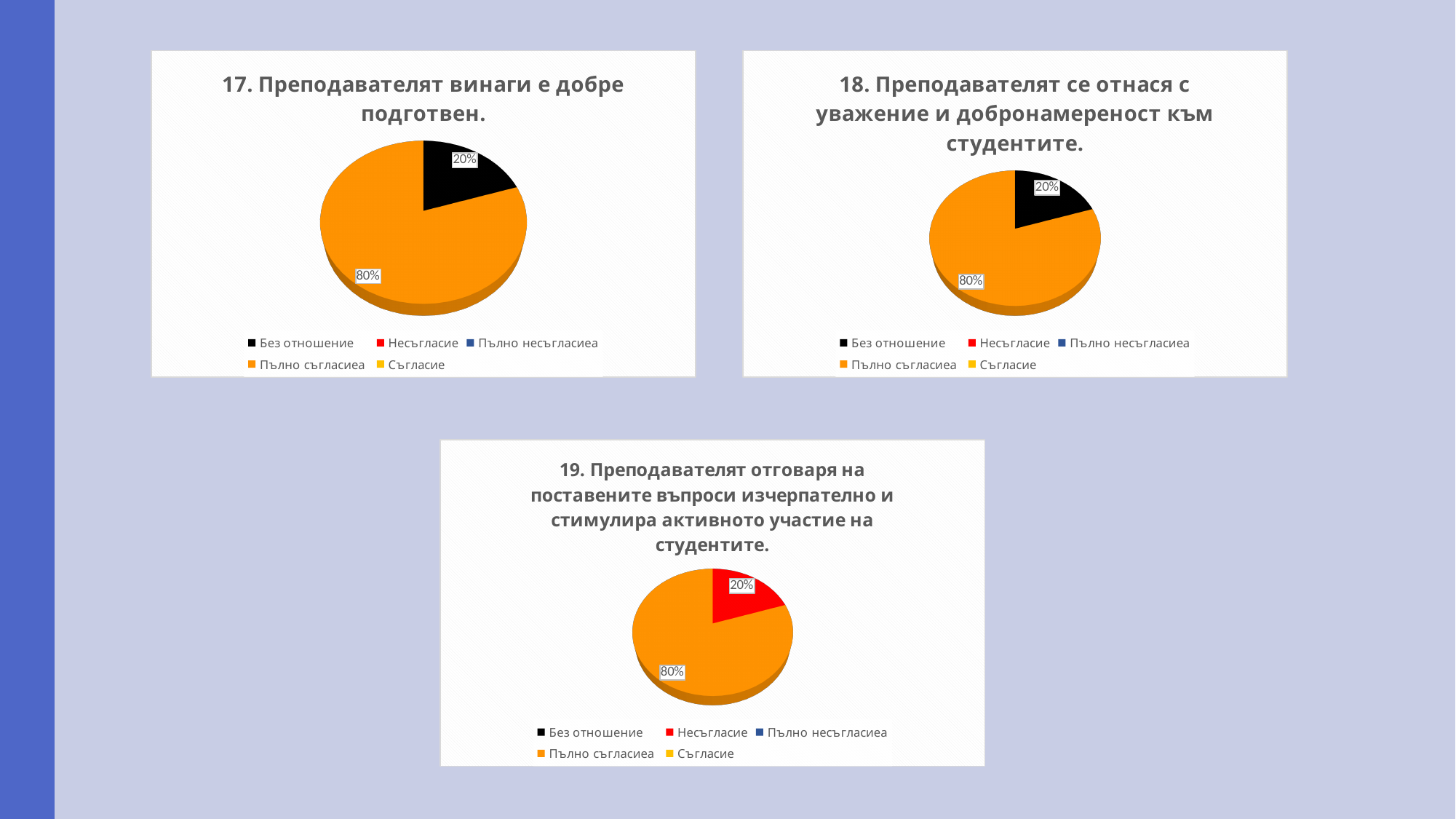
In the chart titled "17. Преподавателят винаги е добре подготвен.", what share of the pie is "Без отношение"? 20% What kind of chart is the chart titled "17. Преподавателят винаги е добре подготвен."? Pie chart In the chart titled "18. Преподавателят се отнася с уважение и добронамереност към студентите.", what is the difference between the "Пълно съгласиеа" slice and the "Без отношение" slice? 60% In the chart titled "19. Преподавателят отговаря на поставените въпроси изчерпателно и стимулира активното участие на студентите.", what colour is the "Несъгласие" slice? Red In the chart titled "18. Преподавателят се отнася с уважение и добронамереност към студентите.", which is larger: "Пълно съгласиеа" or "Без отношение"? Пълно съгласиеа In the chart titled "19. Преподавателят отговаря на поставените въпроси изчерпателно и стимулира активното участие на студентите.", what share of the pie is "Пълно съгласиеа"? 80% In the chart titled "19. Преподавателят отговаря на поставените въпроси изчерпателно и стимулира активното участие на студентите.", which category has the smallest visible slice? Несъгласие In the chart titled "17. Преподавателят винаги е добре подготвен.", which category has the largest slice? Пълно съгласиеа In the chart titled "17. Преподавателят винаги е добре подготвен.", what share of the pie is "Пълно съгласиеа"? 80% How many entries does the legend list in the chart titled "19. Преподавателят отговаря на поставените въпроси изчерпателно и стимулира активното участие на студентите."? 5